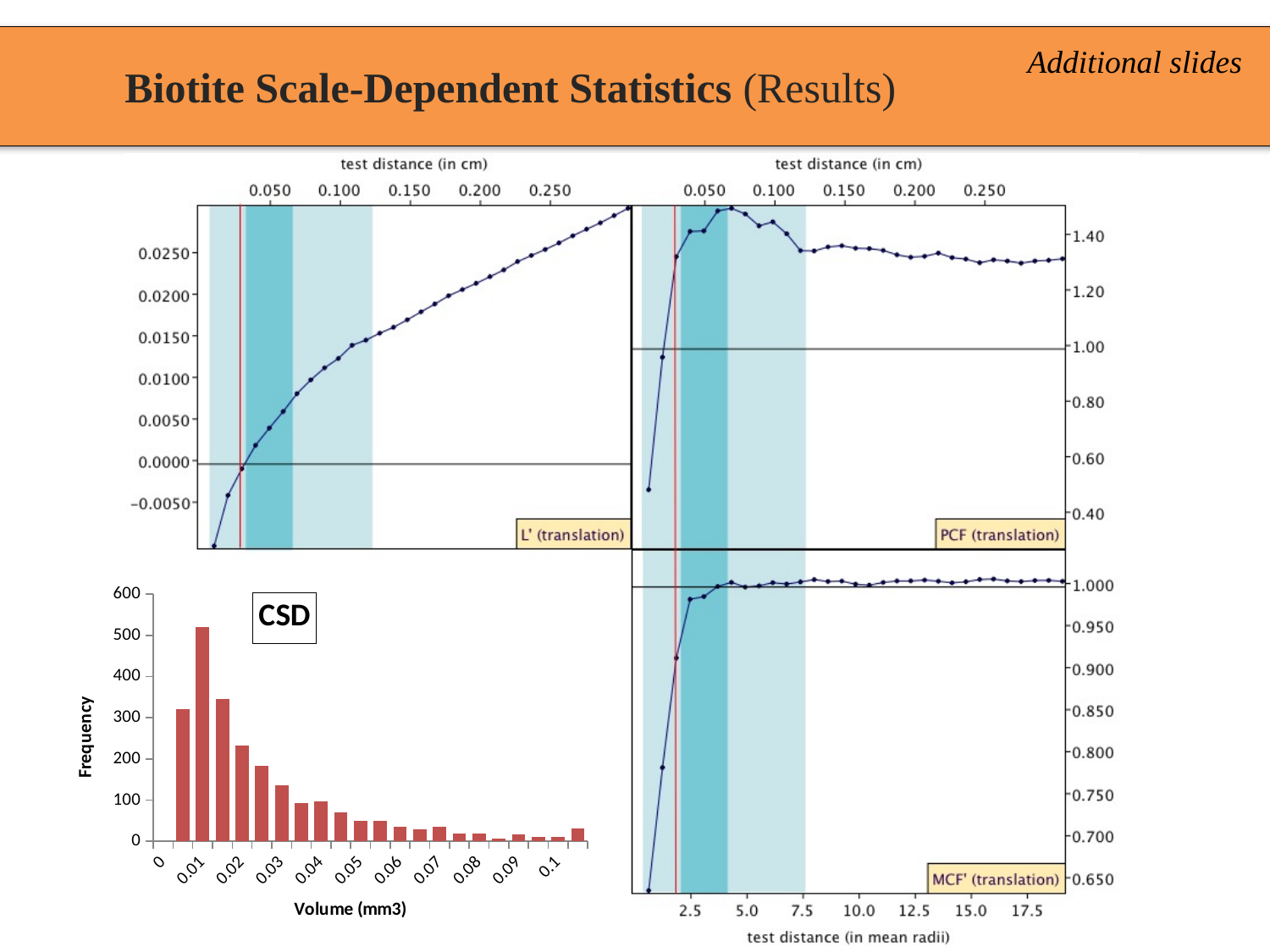
What is the x-axis title of the CSD bar chart? Volume (mm3) In the L' (translation) chart, is the value at test distance 0.250 cm greater or less than 0.0250? greater In the CSD bar chart, do the bar heights generally rise or fall as volume increases beyond 0.01? fall In the CSD bar chart, is the first bar (at volume 0) greater or less than 400? less In the L' (translation) chart, do the values rise or fall as test distance increases? rise In the MCF' (translation) chart, is the value at test distance 17.5 mean radii greater or less than 0.950? greater How many charts are shown on the slide? 4 What kind of chart is the CSD chart at the bottom left of the slide? bar chart What is the y-axis title of the CSD bar chart? Frequency